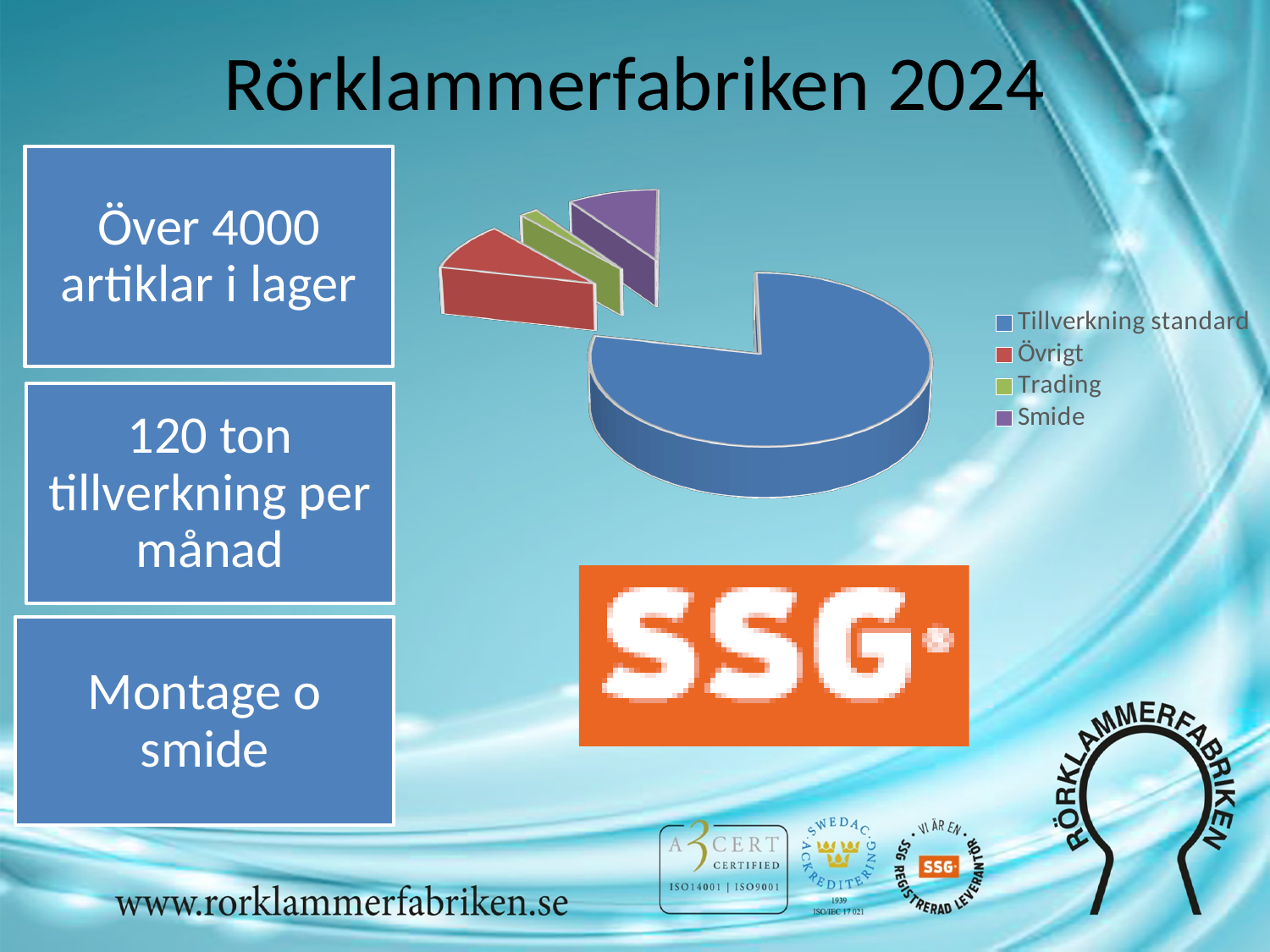
Which category is shown in red in the pie chart? Övrigt What colour is the Smide slice in the pie chart? Purple How many slices does the pie chart have? 4 Which slice is larger in the pie chart, Övrigt or Trading? Övrigt Which slice is larger in the pie chart, Tillverkning standard or Smide? Tillverkning standard Which slice is larger in the pie chart, Tillverkning standard or Övrigt? Tillverkning standard Which category has the largest slice in the pie chart? Tillverkning standard How many entries does the legend of the pie chart list? 4 What kind of chart is shown on the slide? Pie chart